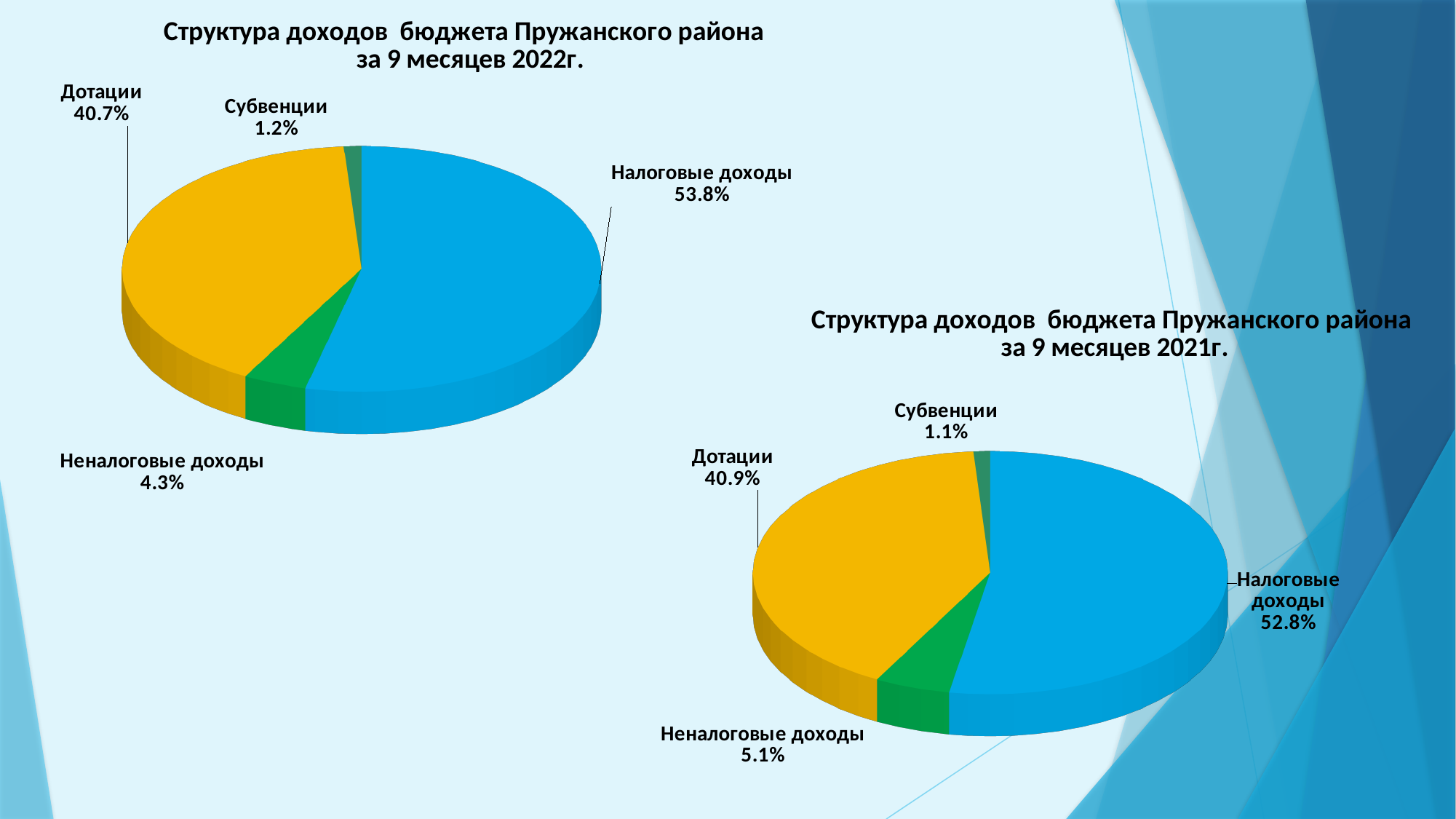
In the 2021 chart, what is the difference between the shares of Дотации and Неналоговые доходы? 35.8% In the 2022 chart (Структура доходов бюджета Пружанского района за 9 месяцев 2022г.), what share is Налоговые доходы? 53.8% What type of chart is used for the 2021 data? Pie chart How many slices does the 2022 chart have? 4 In the 2022 chart, which category has the largest share? Налоговые доходы In the 2021 chart, what share is Субвенции? 1.1% Which is larger: Неналоговые доходы in the 2022 chart or Неналоговые доходы in the 2021 chart? 2021 chart (5.1%) In the 2022 chart, what colour is the Дотации slice? Yellow In the 2022 chart, what share is Дотации? 40.7% In the 2021 chart (за 9 месяцев 2021г.), what share is Неналоговые доходы? 5.1% In the 2021 chart, which category has the smallest share? Субвенции In the 2022 chart, what is the difference between the shares of Налоговые доходы and Дотации? 13.1%